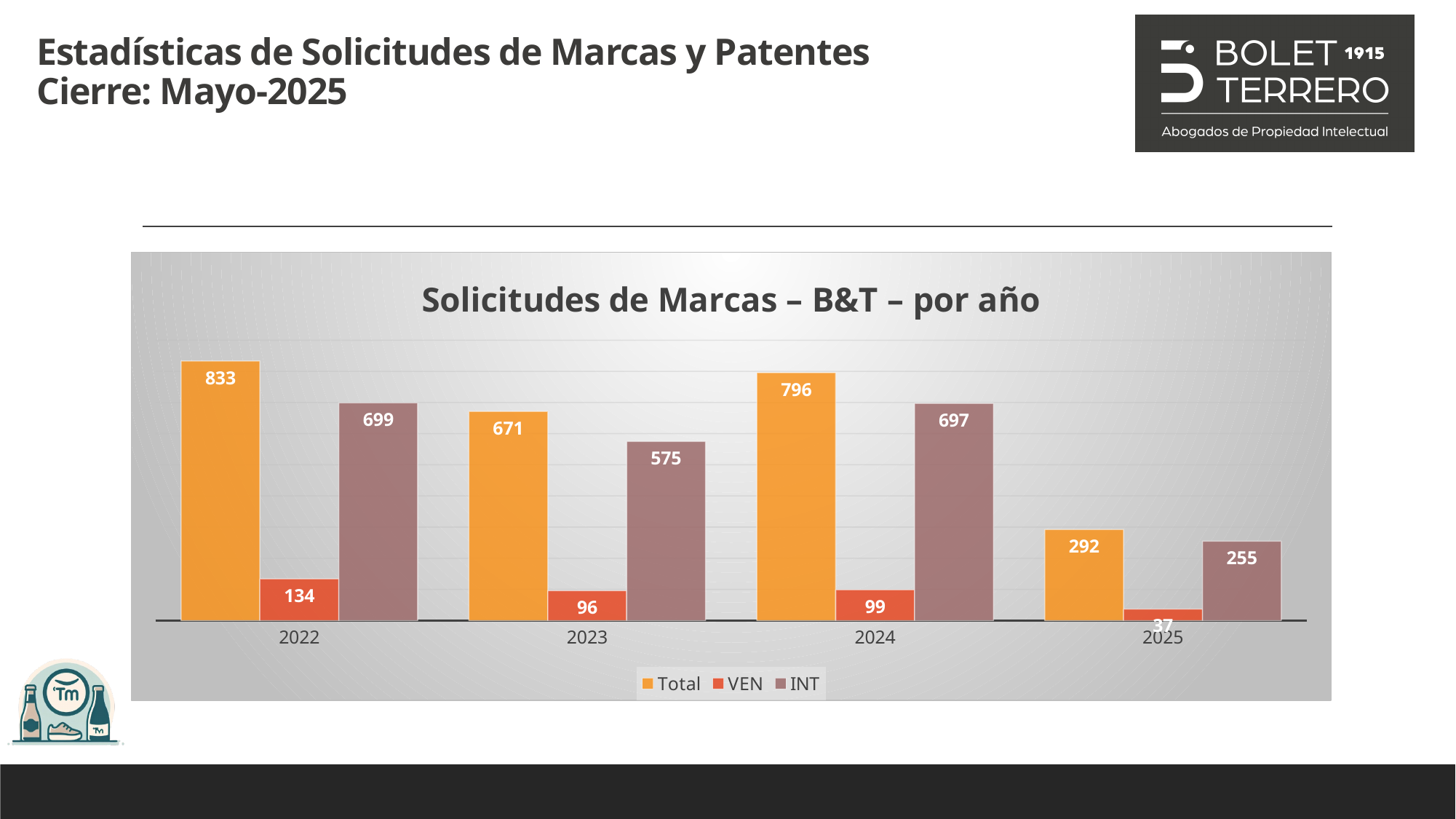
What kind of chart is shown? Bar chart What is the VEN value for 2025? 37 What is the INT value for 2023? 575 What is the title of the chart? Solicitudes de Marcas – B&T – por año What is the difference between the INT and VEN values for 2024? 598 How many series does the legend list? 3 How many years are shown on the x axis? 4 Which year has the lowest INT value? 2025 Which is larger, the VEN value for 2022 or the VEN value for 2023? 2022 Which year has the highest Total value? 2022 What is the difference between the Total values for 2022 and 2024? 37 What is the Total value for 2022? 833